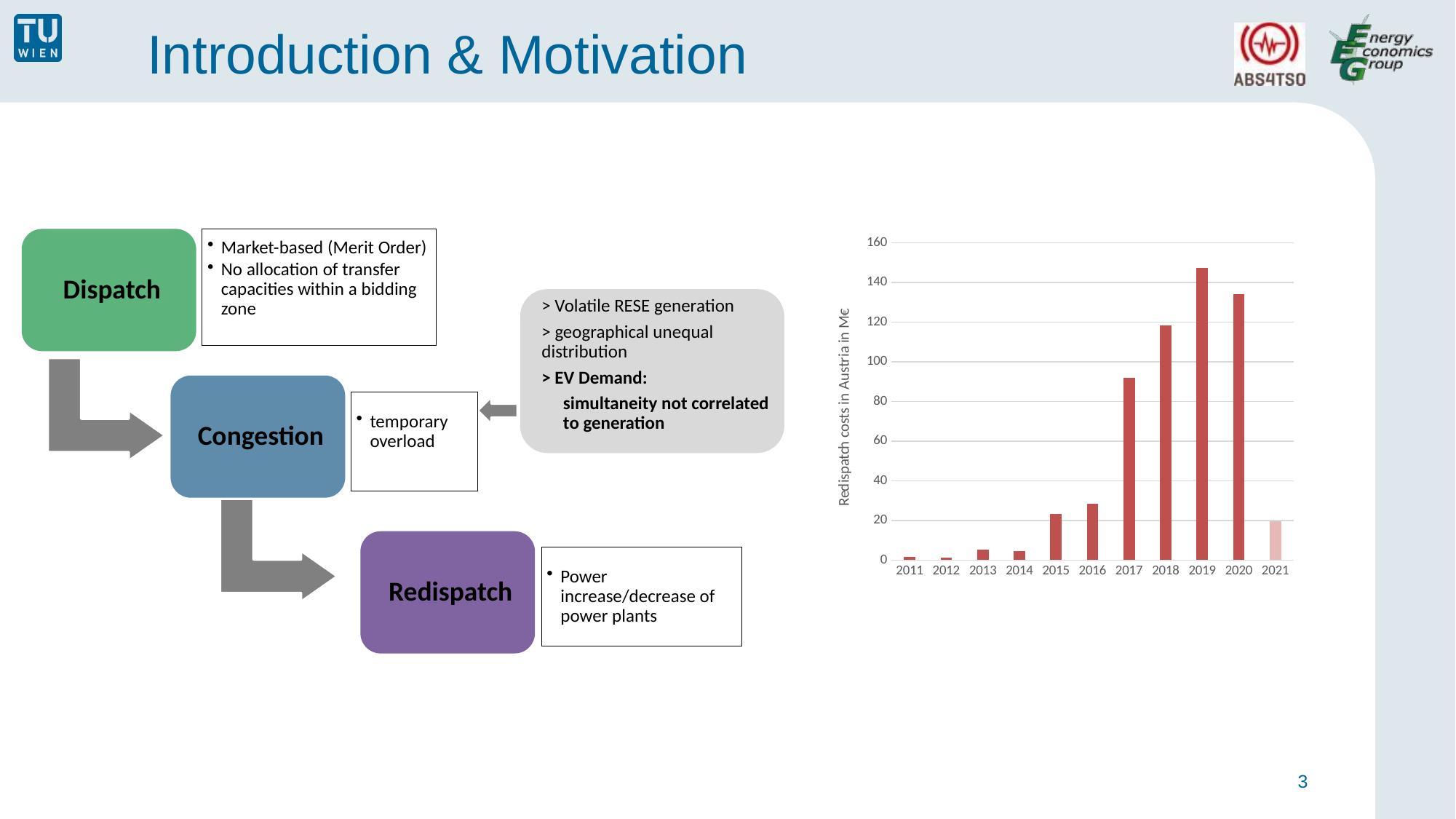
Is the value for 2021 greater or less than 40? less What is the label of the y axis of the chart? Redispatch costs in Austria in M€ Is the value for 2019 greater or less than 140? greater What kind of chart is shown on the right side of the slide? bar chart Is the value for 2020 greater or less than 120? greater Do the redispatch costs rise or fall from 2011 to 2019? rise Which year has higher redispatch costs, 2015 or 2016? 2016 How many years are shown on the x axis of the redispatch costs chart? 11 Which year has higher redispatch costs, 2019 or 2020? 2019 Which year has the highest redispatch costs in the chart? 2019